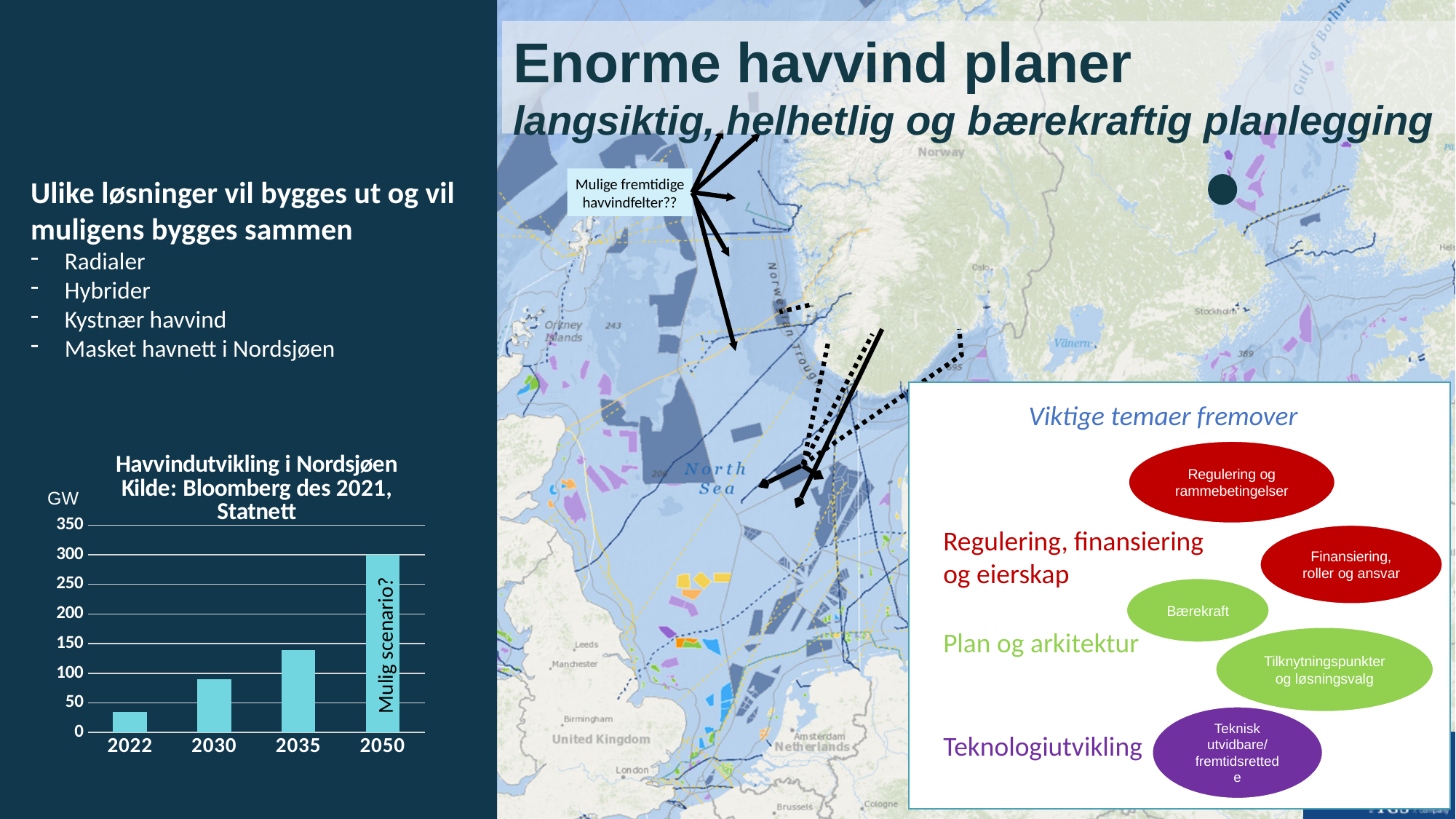
What kind of chart is the 'Havvindutvikling i Nordsjøen' chart? bar chart Is the value for 2030 in the 'Havvindutvikling i Nordsjøen' chart greater or less than 100? less Is the value for 2035 in the 'Havvindutvikling i Nordsjøen' chart greater or less than 100? greater What unit is shown on the y axis of the 'Havvindutvikling i Nordsjøen' chart? GW What is the value for 2050 in the 'Havvindutvikling i Nordsjøen' chart? 300 Which year has the lowest value in the 'Havvindutvikling i Nordsjøen' chart? 2022 Is the value for 2022 in the 'Havvindutvikling i Nordsjøen' chart greater or less than 50? less In the 'Havvindutvikling i Nordsjøen' chart, which is larger, the value for 2030 or the value for 2035? 2035 What text is written on the 2050 bar in the 'Havvindutvikling i Nordsjøen' chart? Mulig scenario? Which year has the highest value in the 'Havvindutvikling i Nordsjøen' chart? 2050 Do the values in the 'Havvindutvikling i Nordsjøen' chart rise or fall from 2022 to 2050? rise How many years are shown on the x axis of the 'Havvindutvikling i Nordsjøen' chart? 4